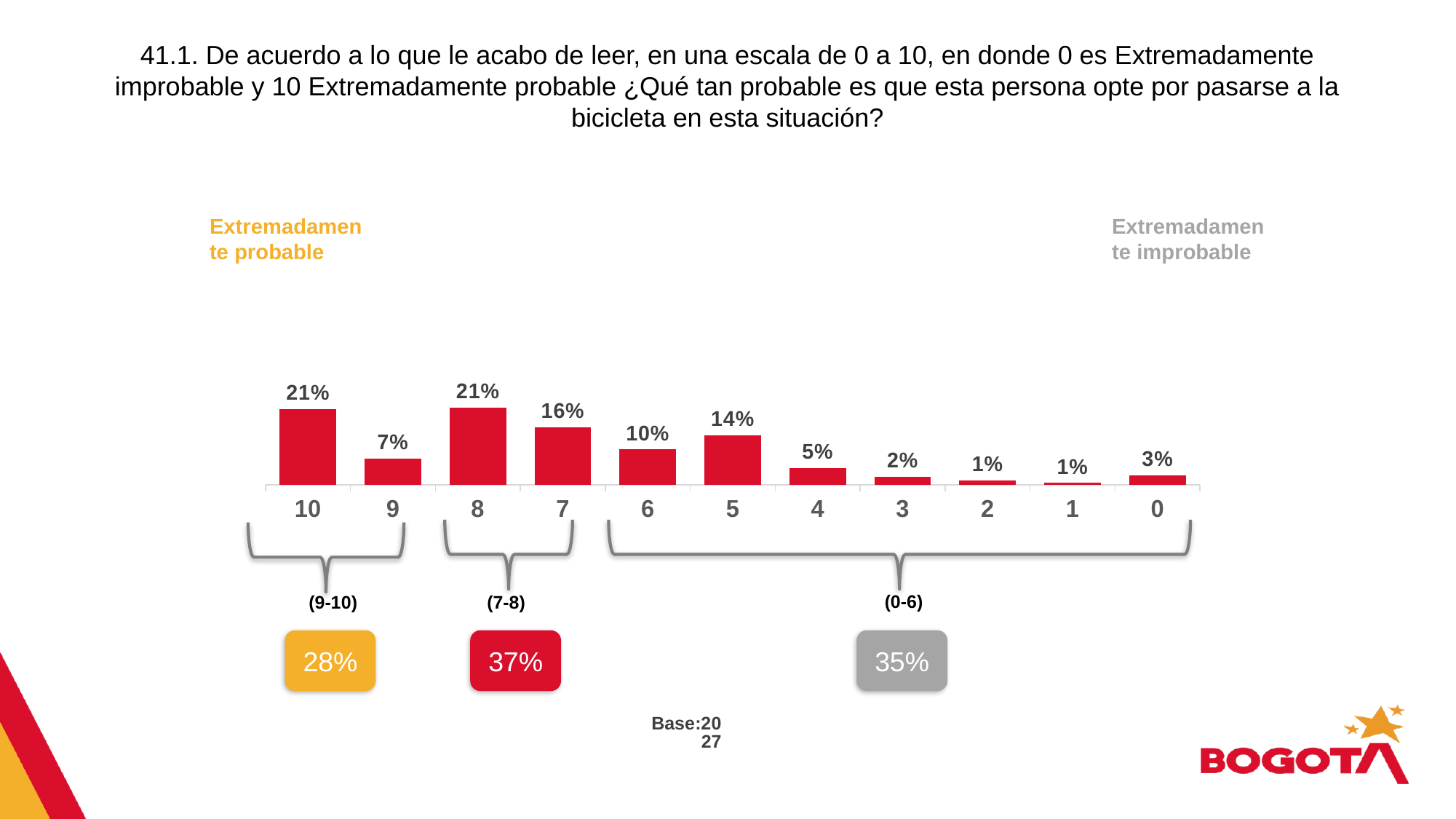
What is the value shown for score 7? 16% What is the difference between the values for score 6 and score 4? 5% What combined percentage is shown for the (0-6) group? 35% What combined percentage is shown for the (7-8) group? 37% What is the difference between the values for score 8 and score 9? 14% What kind of chart is shown on the slide? Bar chart How many score categories are shown on the x axis? 11 Which has a lower value, score 3 or score 0? 3 What percentage of respondents gave a score of 10? 21% Which has a higher value, score 5 or score 6? 5 What percentage is shown for score 5? 14% What is the value for score 0? 3%